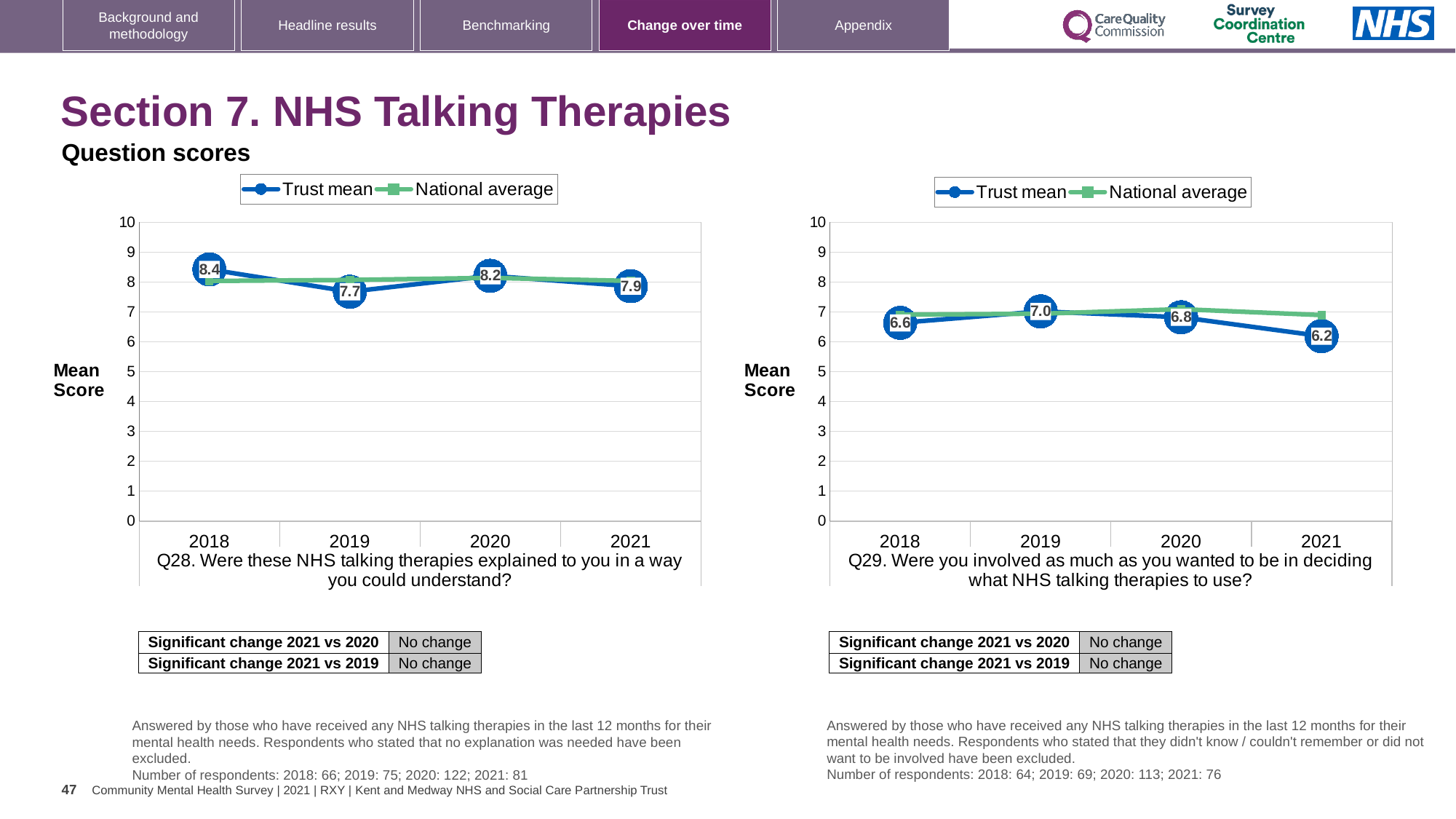
In the Q28 chart (left), which year has the highest Trust mean? 2018 In the Q29 chart (right), what is the Trust mean for 2019? 7.0 In the Q29 chart (right), what is the Trust mean for 2021? 6.2 How many series does the legend of the Q29 chart (right) list? 2 In the Q28 chart (left), what is the difference between the Trust mean for 2018 and 2019? 0.7 In the Q29 chart (right), which year has the lowest Trust mean? 2021 In the Q28 chart (left), what is the Trust mean for 2018? 8.4 What type of chart is the Q28 chart (left)? Line chart How many years are plotted on the x axis of the Q28 chart (left)? 4 In the Q29 chart (right), is the Trust mean for 2020 larger or smaller than the Trust mean for 2021? larger In the Q29 chart (right), is the National average for 2021 greater or less than 5? greater In the Q28 chart (left), what is the Trust mean for 2019? 7.7